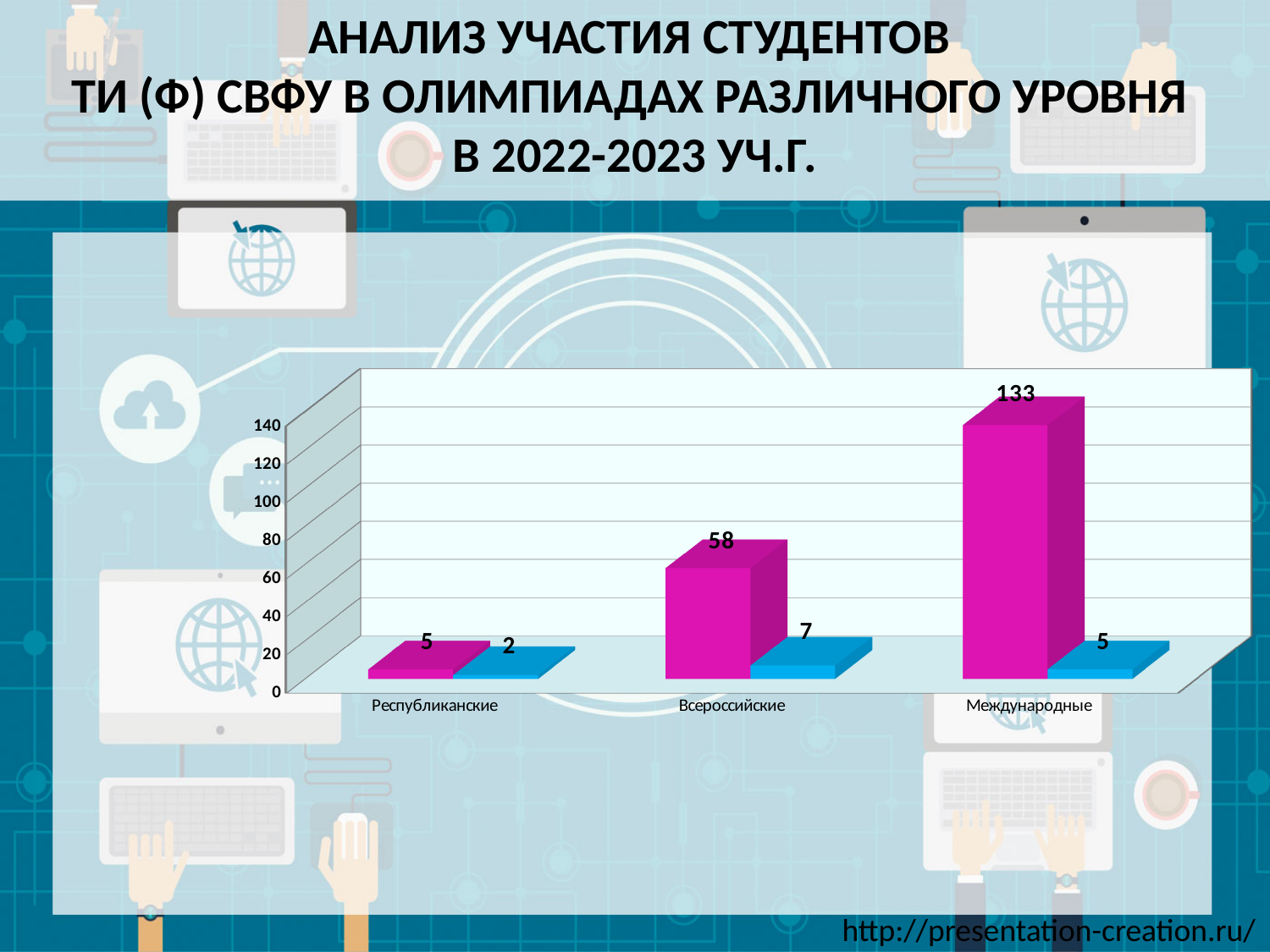
What is the value of the magenta bar for Республиканские? 5 What is the value of the blue bar for Республиканские? 2 What is the value of the magenta bar for Международные? 133 Which category has the highest magenta bar? Международные How many categories are shown on the x axis? 3 Do the magenta bars rise or fall from Республиканские to Международные? rise What kind of chart is shown on the slide? bar chart What is the value of the blue bar for Всероссийские? 7 Is the magenta value for Международные greater or less than 120? greater Which is larger for Всероссийские: the magenta bar or the blue bar? the magenta bar Which category has the lowest blue bar? Республиканские What is the difference between the magenta bars for Международные and Всероссийские? 75